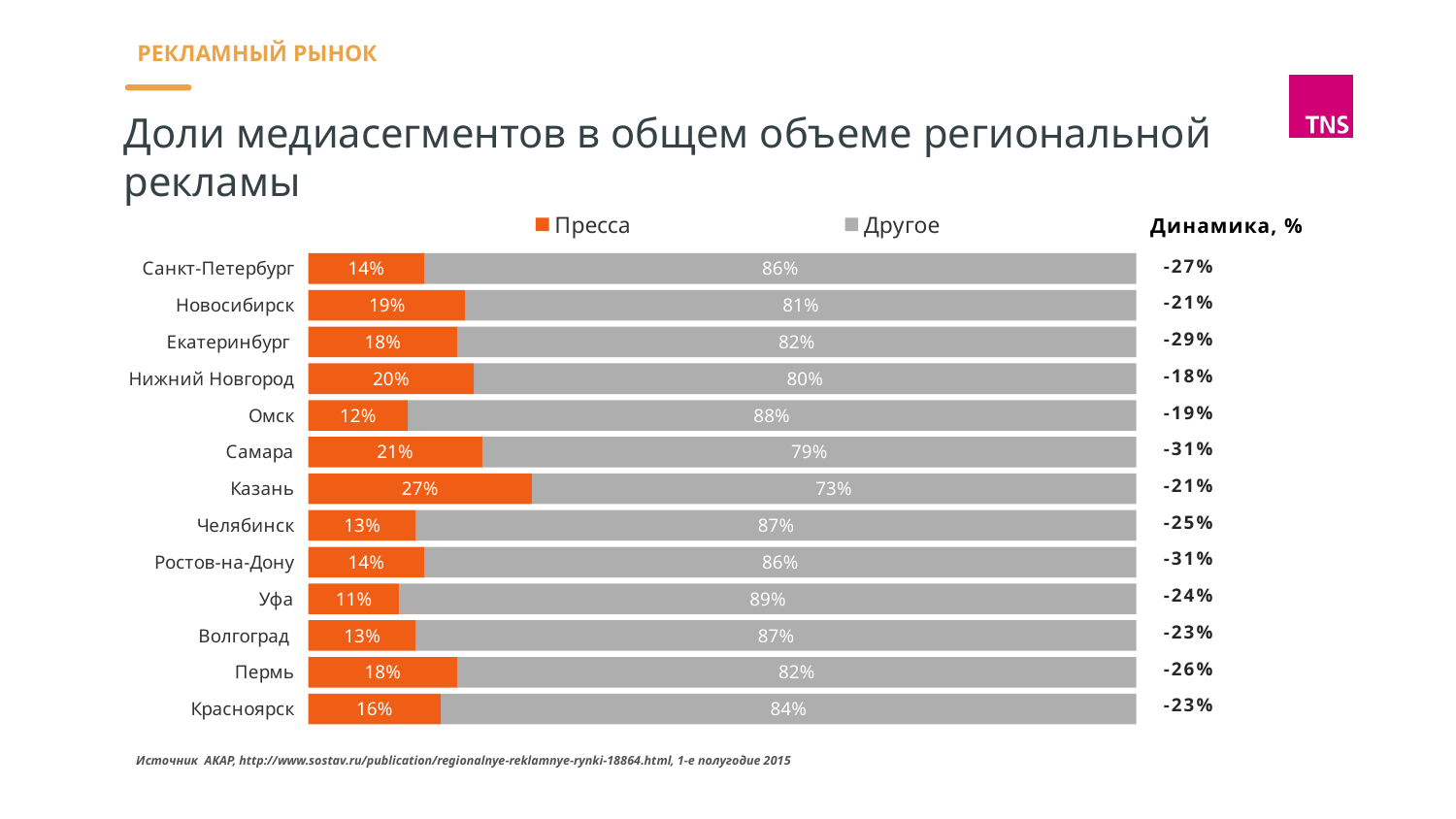
What is the share of Пресса for Казань? 27% Which colour represents Пресса in the chart? Orange Which city has the lowest share of Пресса? Уфа What is the total of the stacked bar for Пермь? 100% How many series does the legend list? 2 How many cities are shown in the chart? 13 Which city has the highest share of Пресса? Казань What is the share of Другое for Уфа? 89% What is the share of Пресса for Омск? 12% Which is larger: the Пресса share for Самара or for Новосибирск? Самара What kind of chart is shown on the slide? Stacked bar chart What is the difference between the Пресса share for Казань and for Санкт-Петербург? 13%